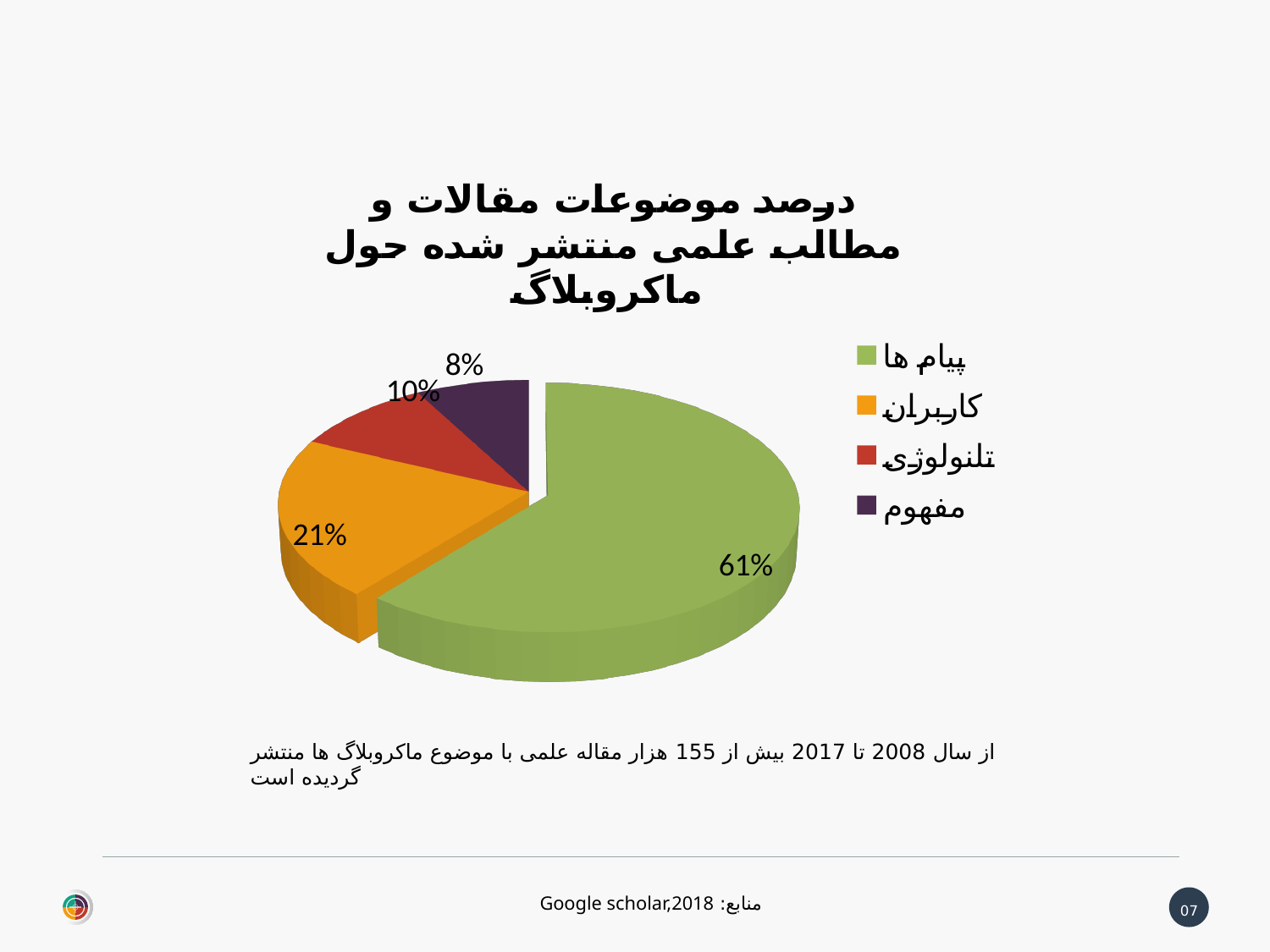
Which is larger, the "تکنولوژی" slice or the "مفهوم" slice? تکنولوژی How many slices does the pie chart have? 4 What is the difference in percentage points between the "پیام ها" slice and the "کاربران" slice? 40 What percentage is shown for the "کاربران" slice? 21% What kind of chart is shown on the slide? Pie chart How many entries does the legend list? 4 What percentage is shown for the "مفهوم" slice? 8% Which category has the smallest share of the pie? مفهوم What colour is the "کاربران" slice? Orange What percentage of the pie does the "پیام ها" slice represent? 61% Which category has the largest share of the pie? پیام ها What percentage is shown for the "تکنولوژی" slice? 10%